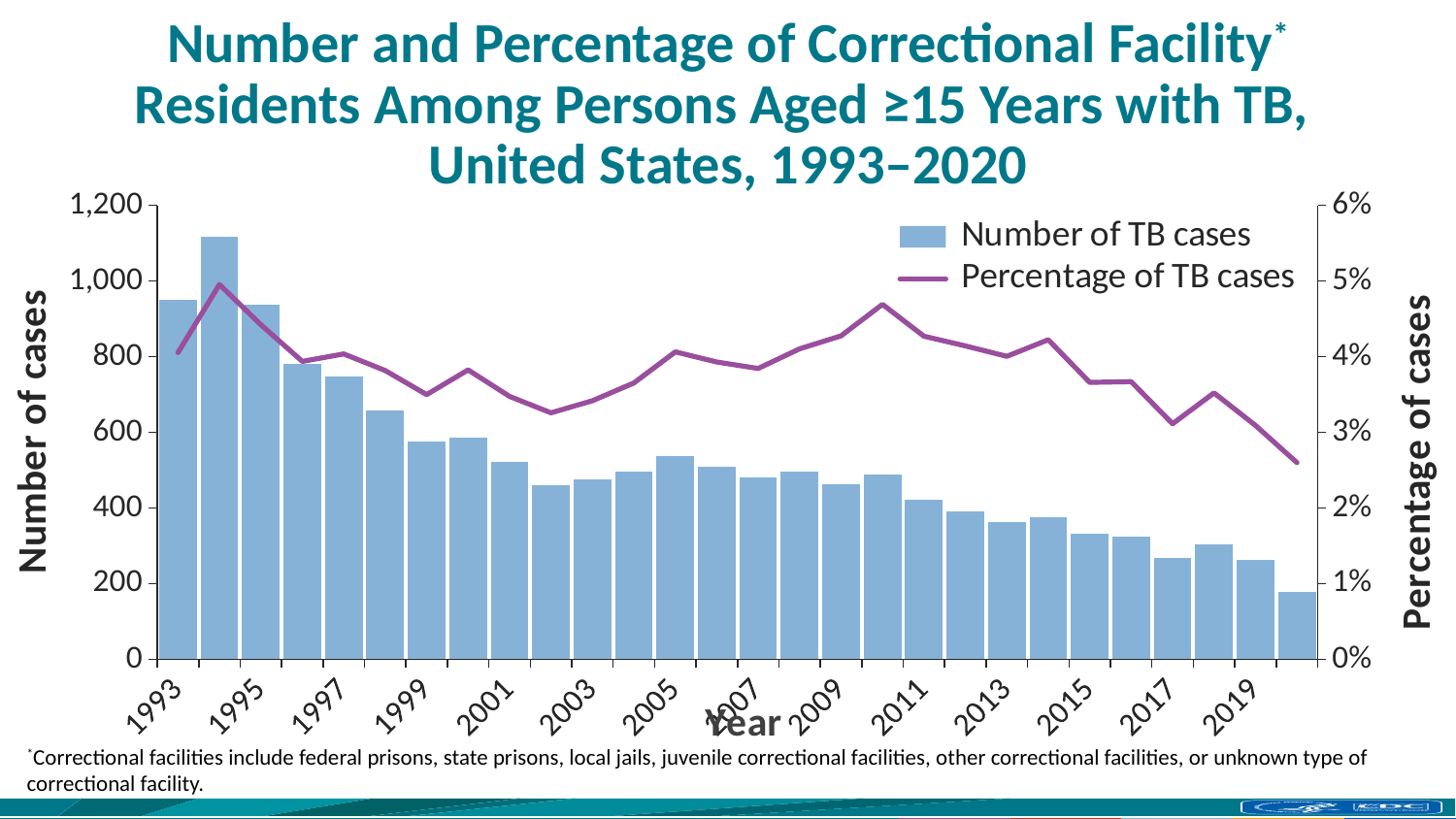
What are the two series named in the legend? Number of TB cases; Percentage of TB cases Which year has the lowest number of TB cases? 2020 Which year has more TB cases, 2000 or 2010? 2000 How many years (bars) are plotted in the chart? 28 Does the number of TB cases generally rise or fall from 1993 to 2020? fall Which year has the lowest percentage of TB cases? 2020 Is the number of TB cases in 2020 greater or less than 200? less Which year has the highest number of TB cases? 1994 Is the percentage of TB cases in 2010 greater or less than 4%? greater What kind of chart is shown on the slide? A combination bar and line chart Is the number of TB cases in 1994 greater or less than 1,000? greater How many series does the legend list? 2